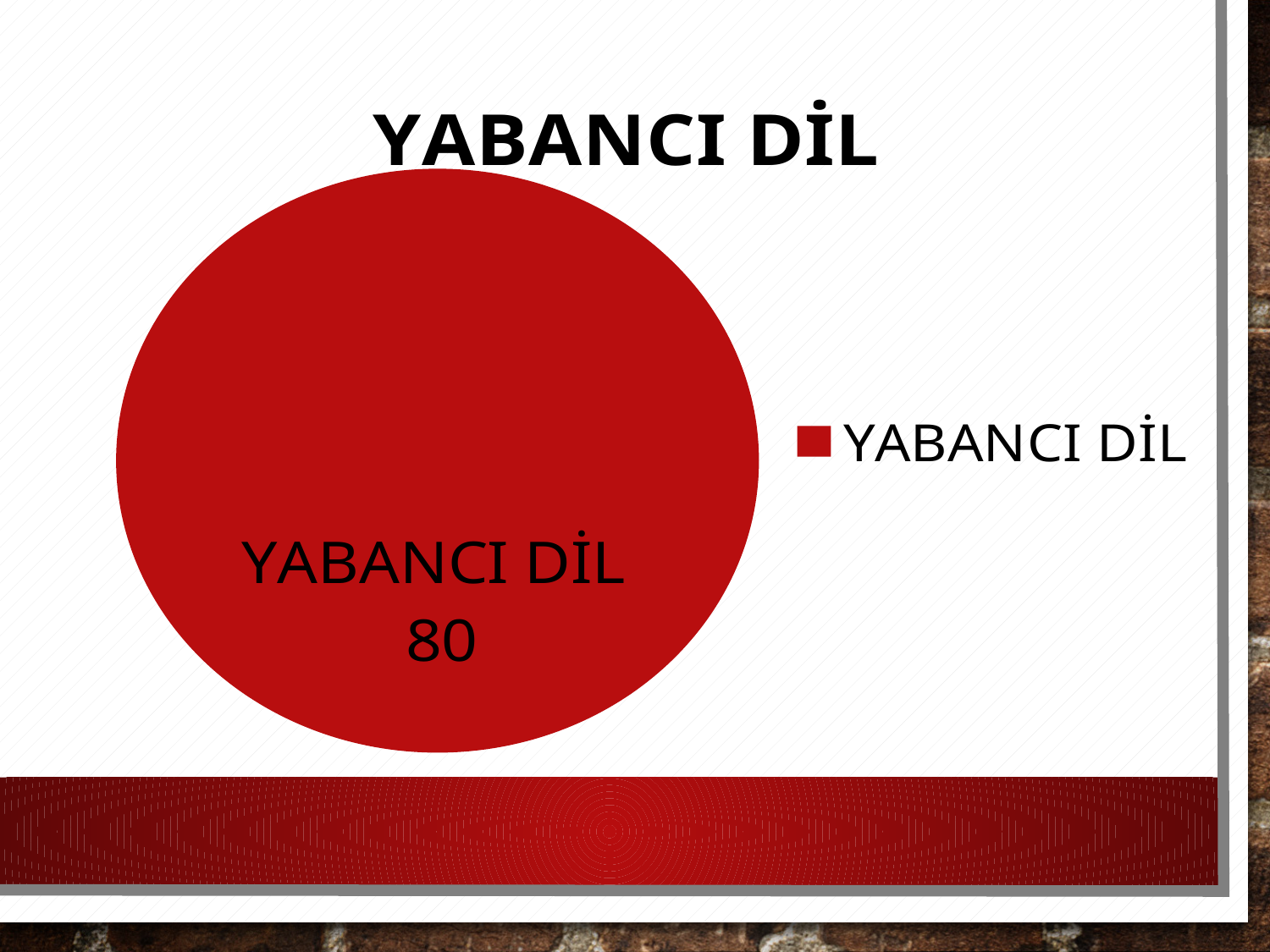
What is the title of the chart? YABANCI DİL What kind of chart is shown on the slide? pie chart What label appears in the legend of the chart? YABANCI DİL What share of the pie does the YABANCI DİL slice take up? 100% Is the value for YABANCI DİL greater or less than 50? greater How many slices does the pie chart have? 1 What value is shown for YABANCI DİL in the pie chart? 80 How many entries does the legend list? 1